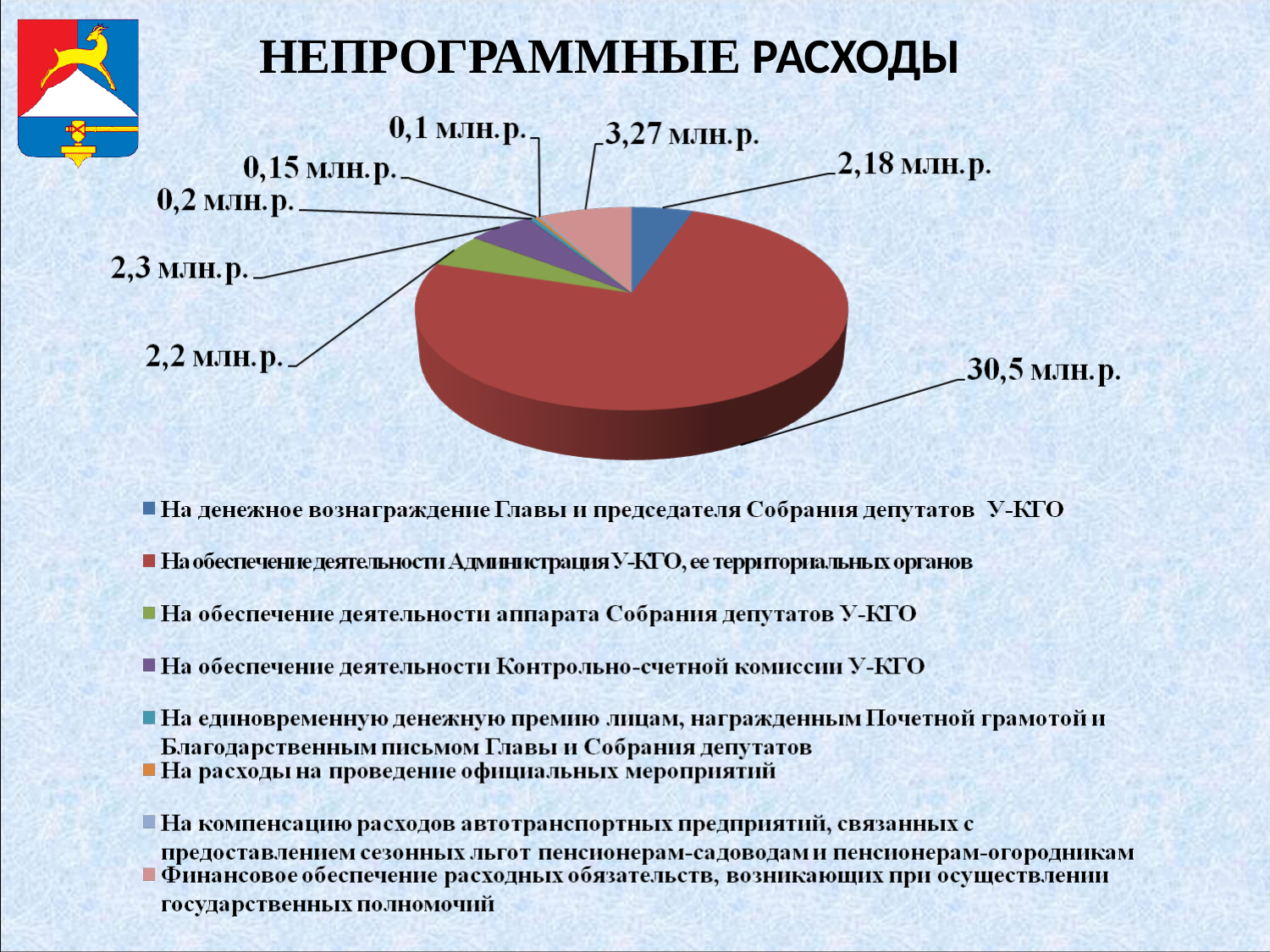
Which category has the largest slice of the pie? На обеспечение деятельности Администрация У-КГО, ее территориальных органов How many slices does the pie chart have? 8 What is the value of the largest slice? 30,5 млн.р. Which is larger: the slice for 'На денежное вознаграждение Главы и председателя Собрания депутатов У-КГО' or the slice for 'Финансовое обеспечение расходных обязательств, возникающих при осуществлении государственных полномочий'? Финансовое обеспечение расходных обязательств, возникающих при осуществлении государственных полномочий What is the smallest value shown on the pie chart? 0,1 млн.р. What colour is the largest slice of the pie? Red What is the value for 'На расходы на проведение официальных мероприятий'? 0,15 млн.р. What kind of chart is shown on the slide? Pie chart What is the value for 'На денежное вознаграждение Главы и председателя Собрания депутатов У-КГО'? 2,18 млн.р. What is the title of the chart? НЕПРОГРАММНЫЕ РАСХОДЫ What is the value for 'Финансовое обеспечение расходных обязательств, возникающих при осуществлении государственных полномочий'? 3,27 млн.р. What is the difference between the largest slice (30,5 млн.р.) and the slice labelled 3,27 млн.р.? 27,23 млн.р.